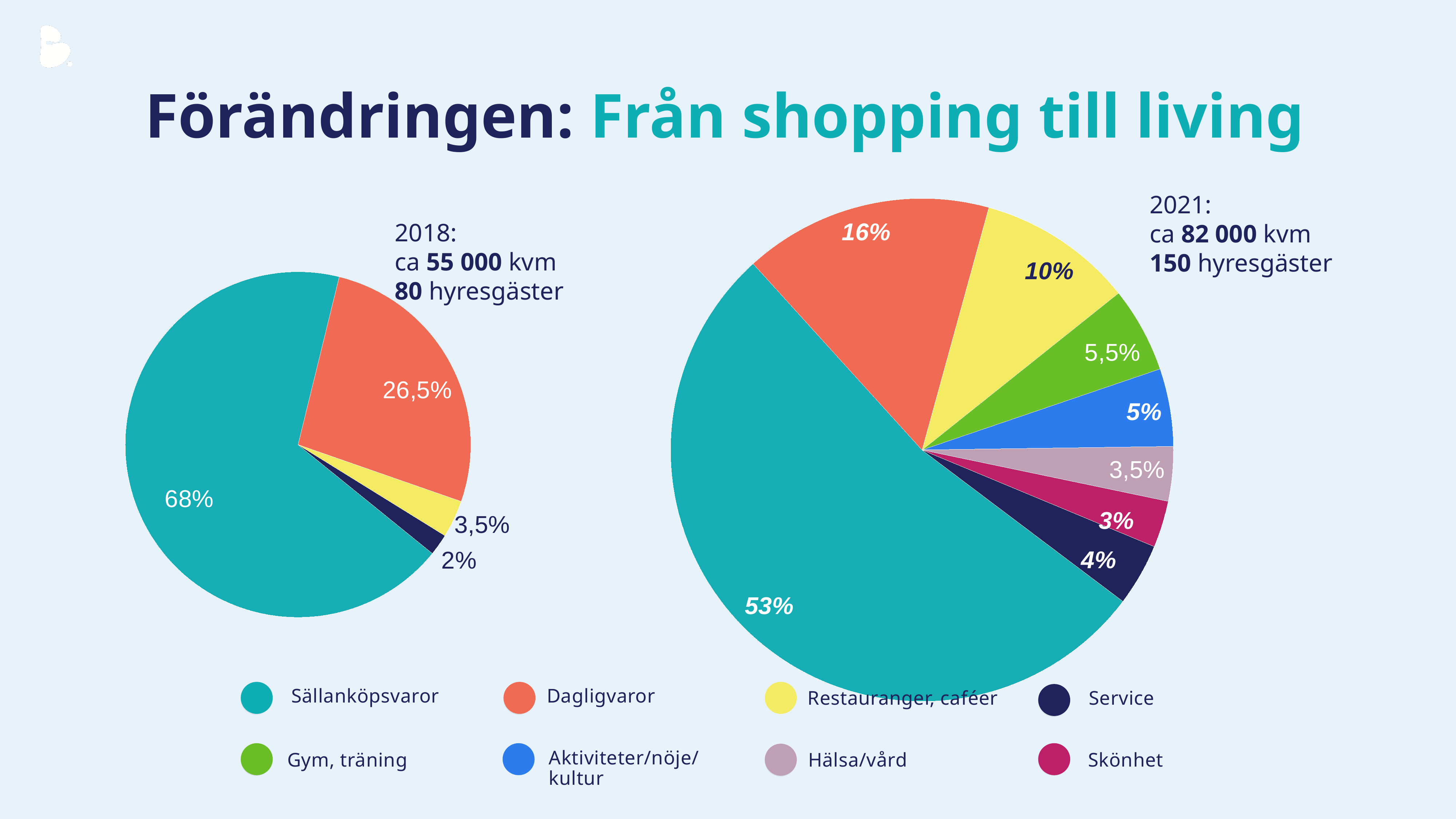
In the 2021 pie chart, which is larger: Aktiviteter/nöje/kultur or Service? Aktiviteter/nöje/kultur In the 2021 pie chart, what share does Sällanköpsvaror have? 53% In the 2021 pie chart, which category has the smallest slice? Skönhet By how many percentage points did the Sällanköpsvaror share fall from the 2018 pie chart to the 2021 pie chart? 15 percentage points What kind of charts are shown on the slide? Pie charts How many slices does the 2021 pie chart have? 8 How many slices does the 2018 pie chart have? 4 In the 2018 pie chart, which category has the smallest slice? Service In the 2021 pie chart, what share does Restauranger, caféer have? 10% In the 2018 pie chart, what share does Dagligvaror have? 26,5% In the 2021 pie chart, what share does Gym, träning have? 5,5% In the 2018 pie chart, what share does Sällanköpsvaror have? 68%